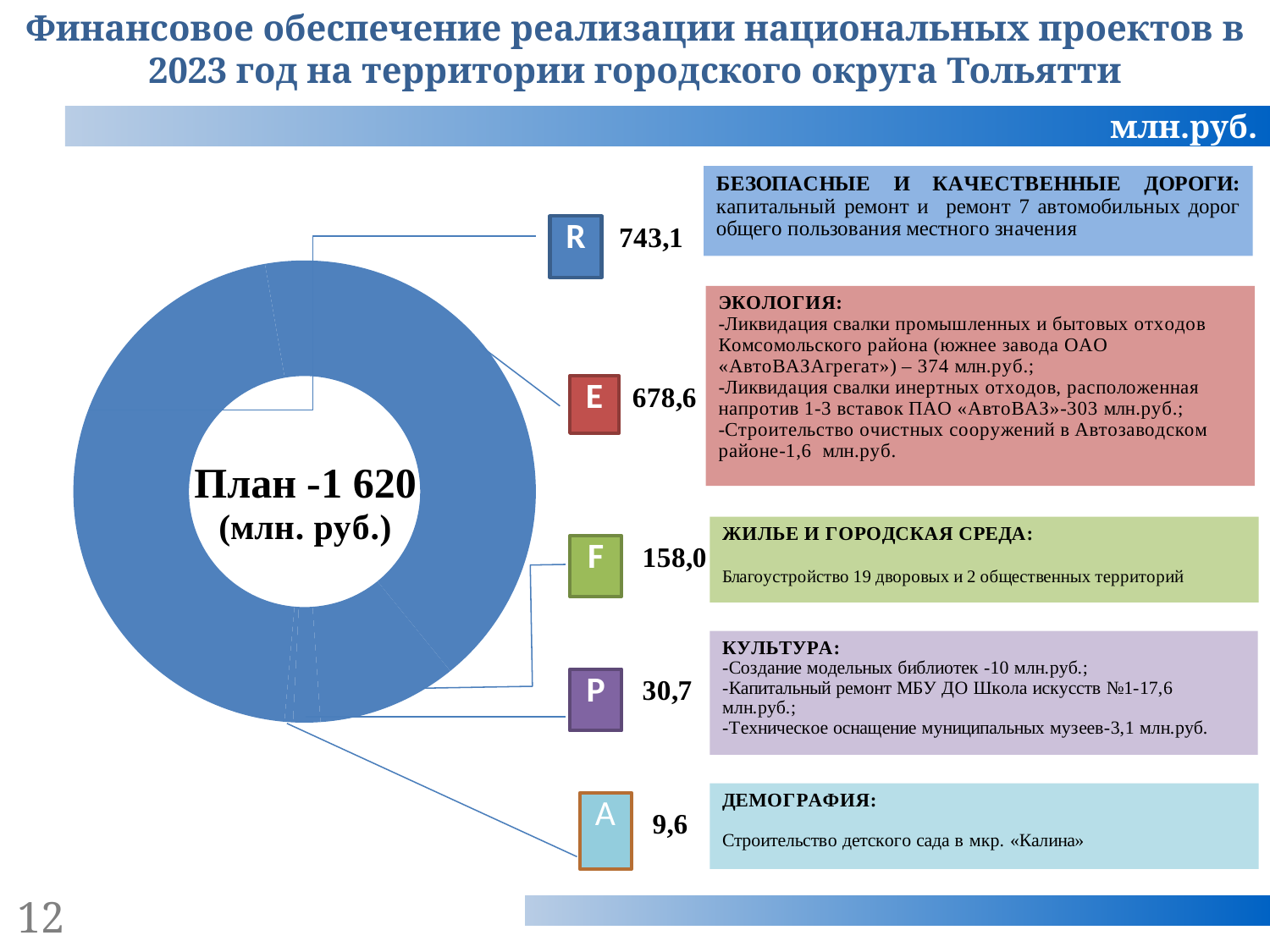
What is the difference between the values for segments F and P? 127,3 What is the value shown for the segment labelled R (Безопасные и качественные дороги)? 743,1 What kind of chart is shown on the slide? Pie (doughnut) chart What is the value shown for the segment labelled F (Жилье и городская среда)? 158,0 How many segments does the chart have? 5 What is the value shown for the segment labelled E (Экология)? 678,6 What is the value shown for the segment labelled P (Культура)? 30,7 What is the value shown for the segment labelled A (Демография)? 9,6 Which segment has the smallest value? A (Демография), 9,6 Which is larger, the value for segment E or the value for segment F? E (678,6) What is the difference between the values for segments R and E? 64,5 Which segment has the largest value? R (Безопасные и качественные дороги), 743,1